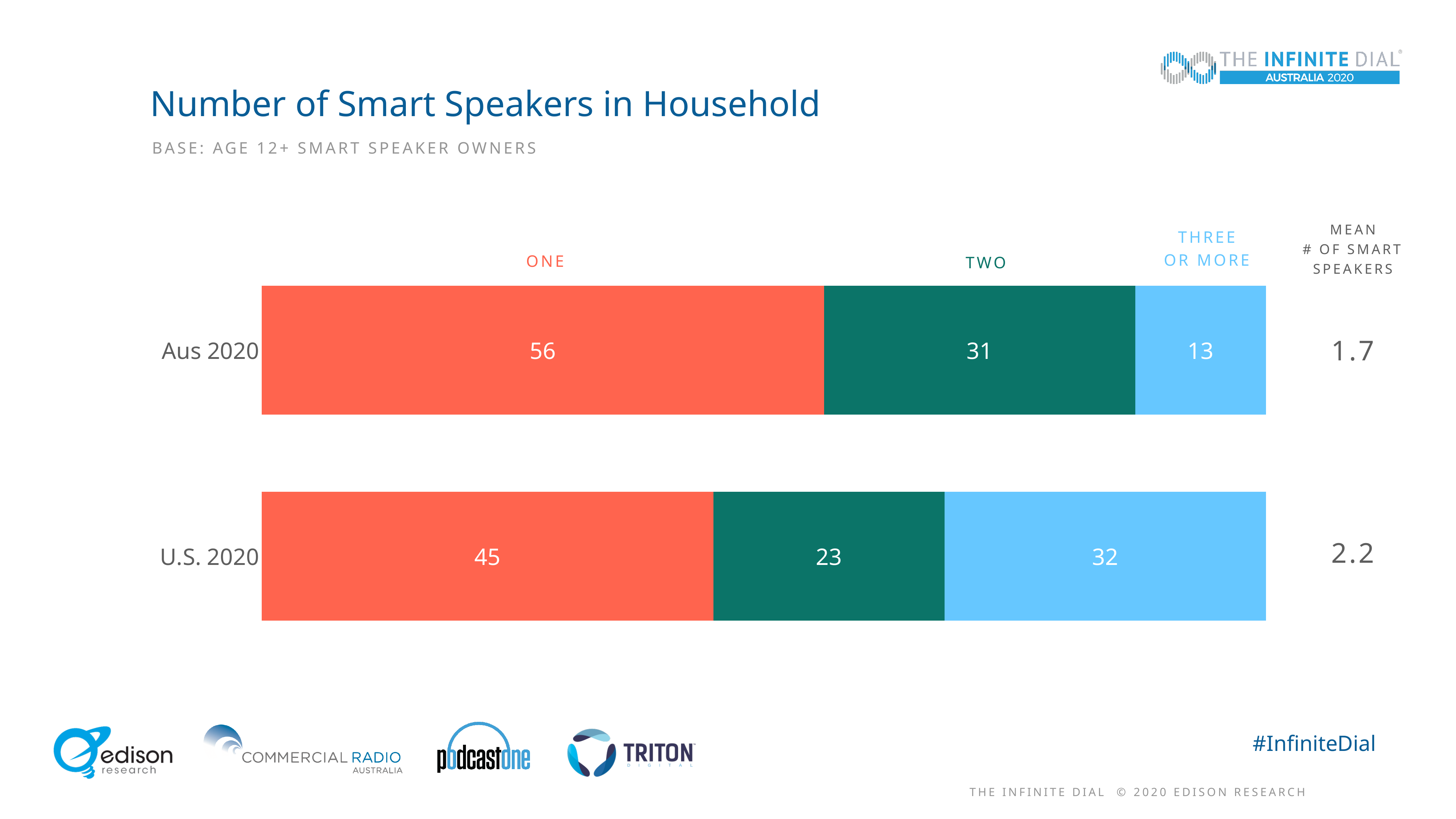
What is the value for ONE for Aus 2020? 56 What is the difference between the ONE values for Aus 2020 and U.S. 2020? 11 How many bars (rows) are shown in the chart? 2 How many series does the chart show? 3 What is the mean number of smart speakers for U.S. 2020? 2.2 Which category has the highest value for U.S. 2020? ONE Which is larger, the THREE OR MORE value for Aus 2020 or for U.S. 2020? U.S. 2020 Which category has the lowest value for Aus 2020? THREE OR MORE What is the value for TWO for Aus 2020? 31 What is the total of the stacked bar for Aus 2020? 100 What kind of chart is shown on the slide? Stacked bar chart What is the value for THREE OR MORE for U.S. 2020? 32